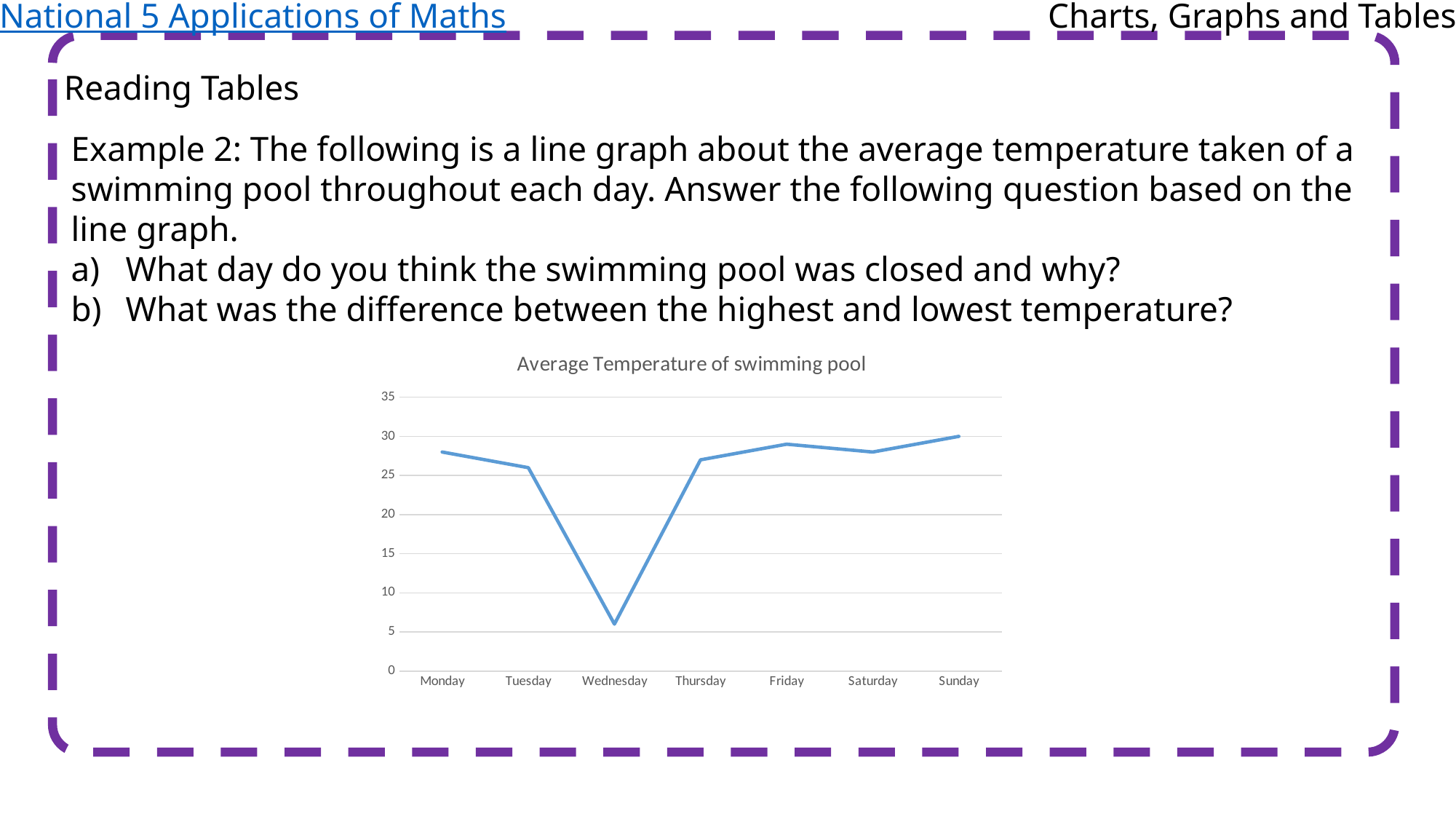
Which is larger, the value for Sunday or the value for Tuesday? Sunday Is the value for Friday greater or less than 30? less Is the value for Wednesday greater or less than 10? less What is the title of the chart? Average Temperature of swimming pool Which day has the highest average temperature? Sunday Which is larger, the value for Monday or the value for Wednesday? Monday Do the values rise or fall from Wednesday to Thursday? rise What kind of chart is shown on the slide? line chart How many days are plotted on the x axis of the chart? 7 Which day has the lowest average temperature? Wednesday Is the value for Monday greater or less than 25? greater